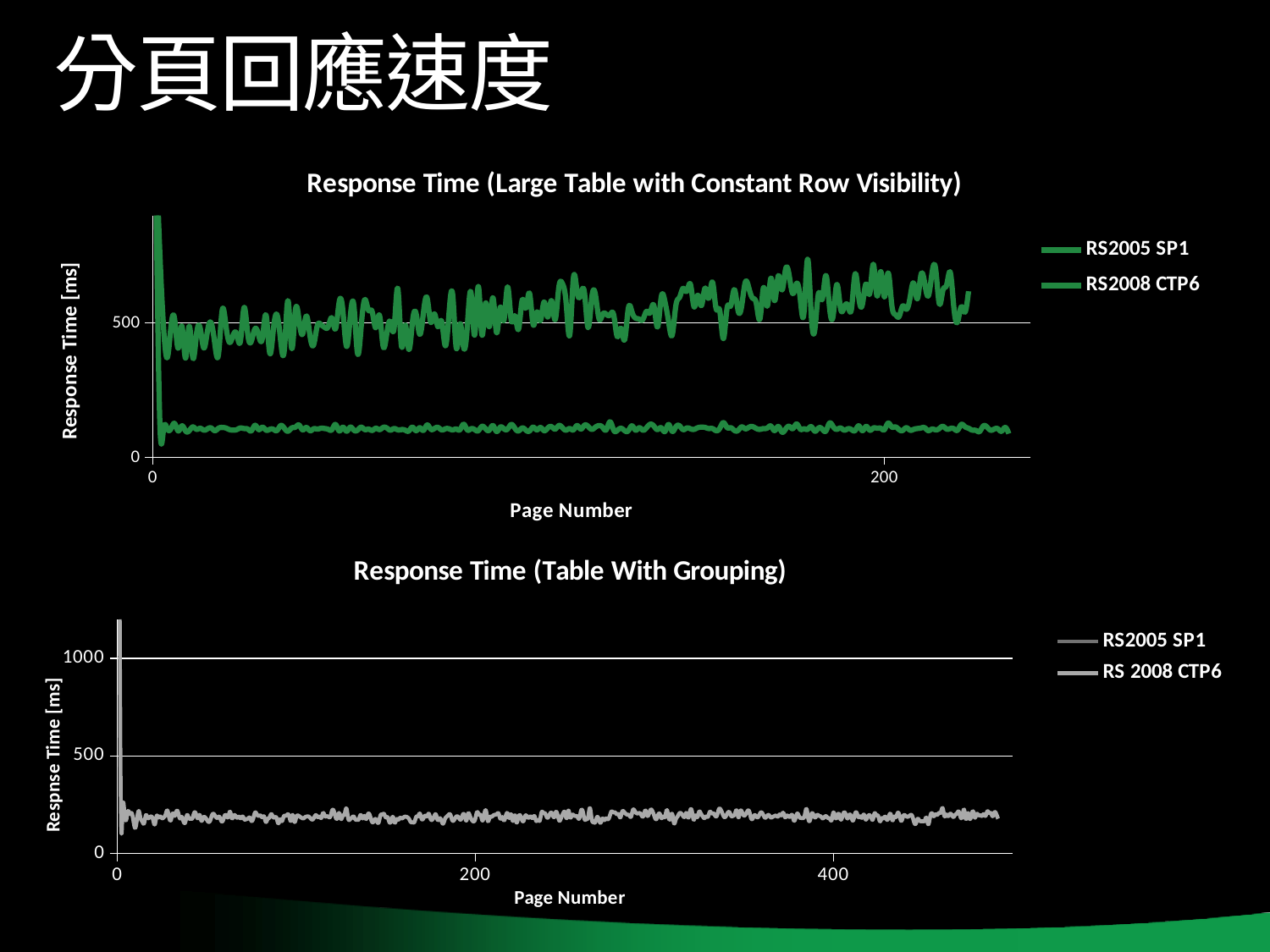
What kind of chart is the top chart, titled "Response Time (Large Table with Constant Row Visibility)"? Line chart In the top chart, titled "Response Time (Large Table with Constant Row Visibility)", is the value of the lower line at page number 200 greater or less than 500? less What is the title of the top chart? Response Time (Large Table with Constant Row Visibility) In the top chart, titled "Response Time (Large Table with Constant Row Visibility)", does the upper line generally rise or fall as the page number increases from 0 to 200? Rise How many series does the legend of the bottom chart list? 2 What is the x-axis label of the bottom chart, titled "Response Time (Table With Grouping)"? Page Number How many series does the legend of the top chart list? 2 In the bottom chart, titled "Response Time (Table With Grouping)", is the peak value at the very start of the series greater or less than 1000? greater In the top chart, titled "Response Time (Large Table with Constant Row Visibility)", is the peak value at the very start of the series greater or less than 500? greater What kind of chart is the bottom chart, titled "Response Time (Table With Grouping)"? Line chart